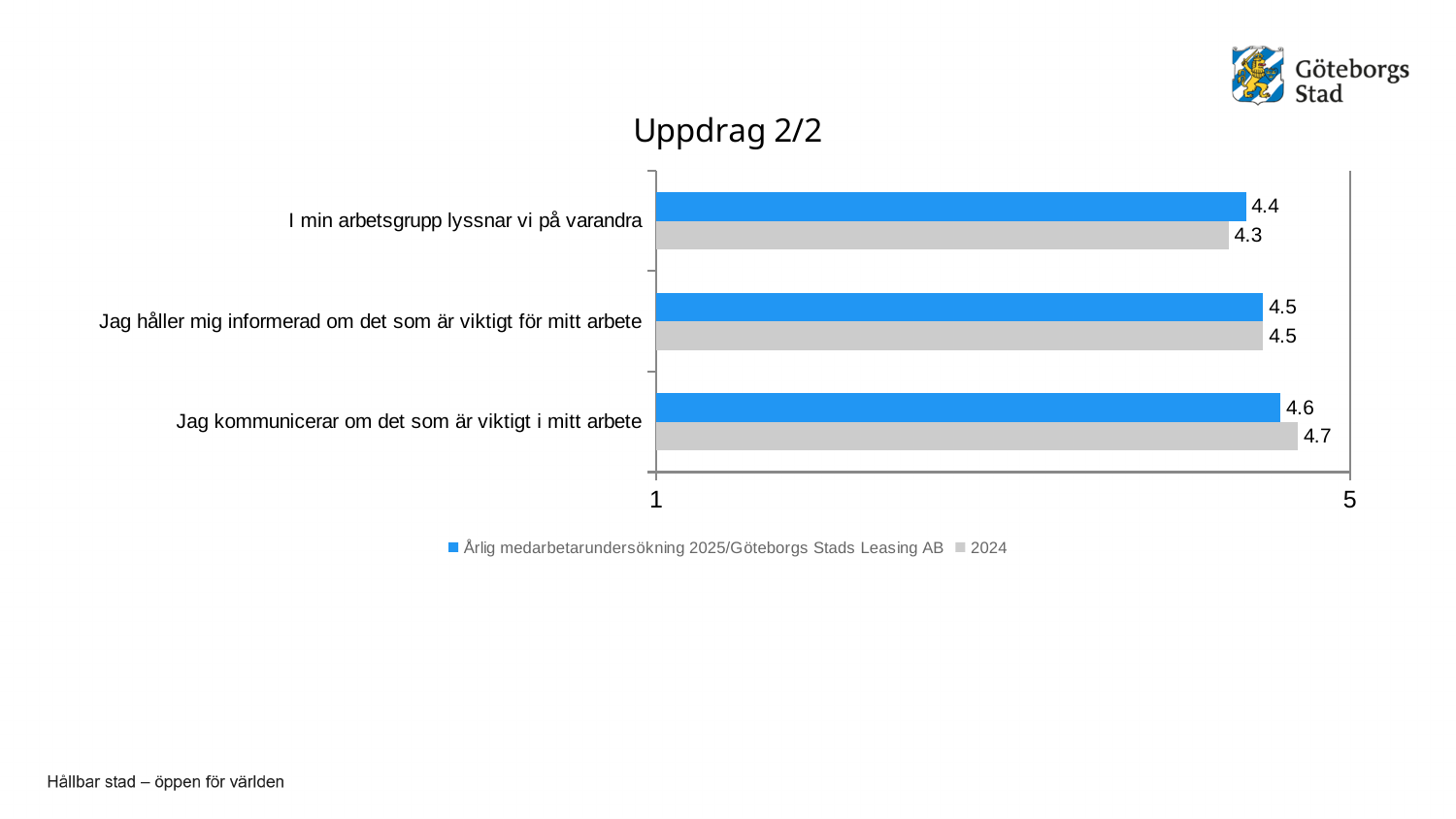
Which statement has the lowest 2024 value? I min arbetsgrupp lyssnar vi på varandra How many series does the legend list? 2 What is the 2025 value for "Jag håller mig informerad om det som är viktigt för mitt arbete"? 4.5 What is the 2025 value for "I min arbetsgrupp lyssnar vi på varandra"? 4.4 What is the title of the chart? Uppdrag 2/2 What is the difference between the 2025 and 2024 values for "I min arbetsgrupp lyssnar vi på varandra"? 0.1 Which statement has the highest 2025 value? Jag kommunicerar om det som är viktigt i mitt arbete What kind of chart is shown on the slide? Bar chart What is the 2024 value for "I min arbetsgrupp lyssnar vi på varandra"? 4.3 How many statements (categories) are shown in the chart? 3 What is the 2024 value for "Jag kommunicerar om det som är viktigt i mitt arbete"? 4.7 For "Jag kommunicerar om det som är viktigt i mitt arbete", which year has the larger value, 2025 or 2024? 2024